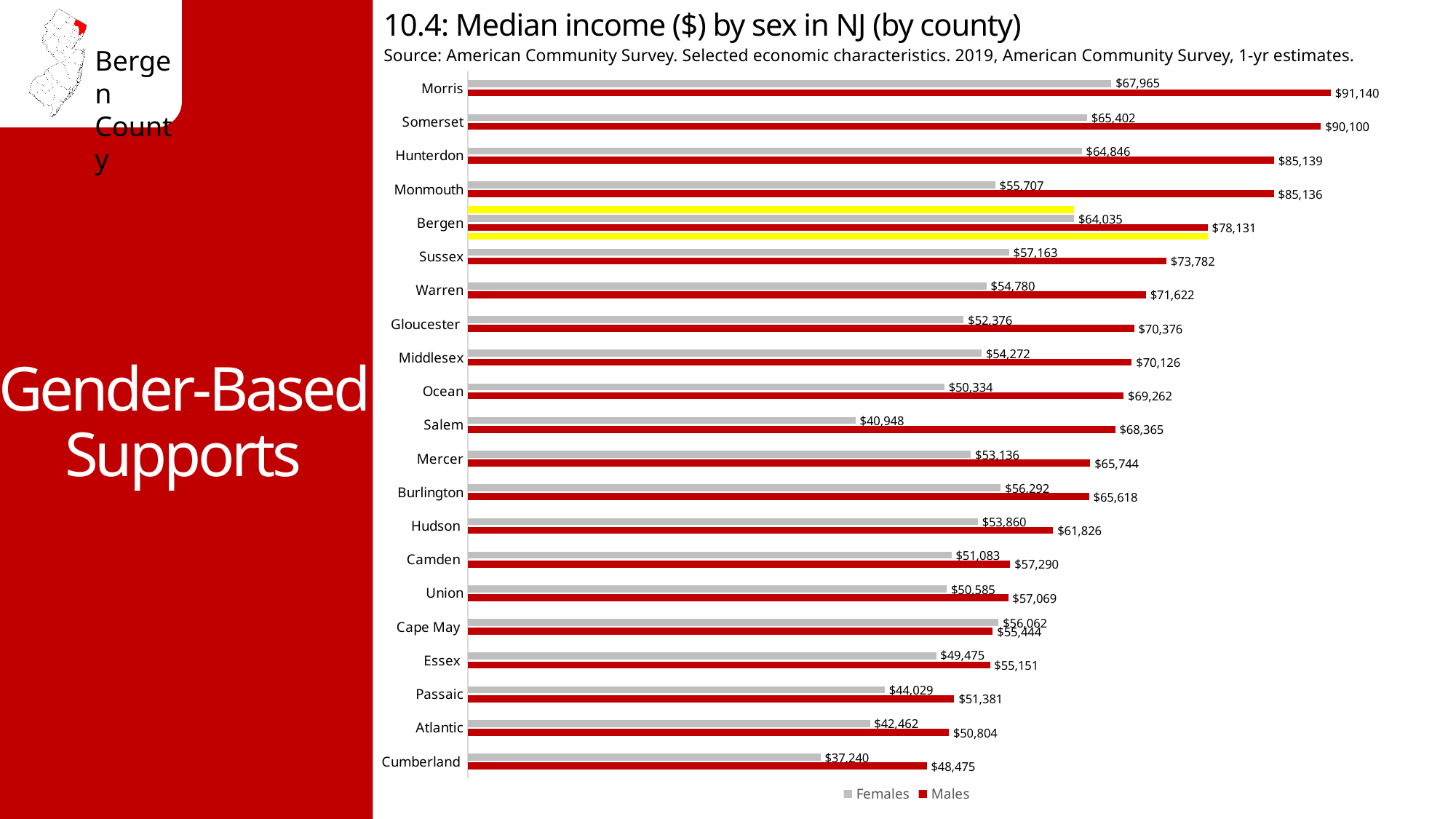
What is the difference between the male and female median incomes in Bergen County? $14,096 How many counties are shown in the chart? 21 What is the median income for males in Monmouth County? $85,136 What is the median income for males in Bergen County? $78,131 What is the median income for females in Salem County? $40,948 Which county has the lowest median income for females? Cumberland In Cape May County, which is larger: the median income for females or for males? Females What type of chart is shown on the slide? Bar chart How many series does the legend list? 2 Which county has the highest median income for males? Morris What is the median income for females in Bergen County? $64,035 What is the difference between the male and female median incomes in Morris County? $23,175